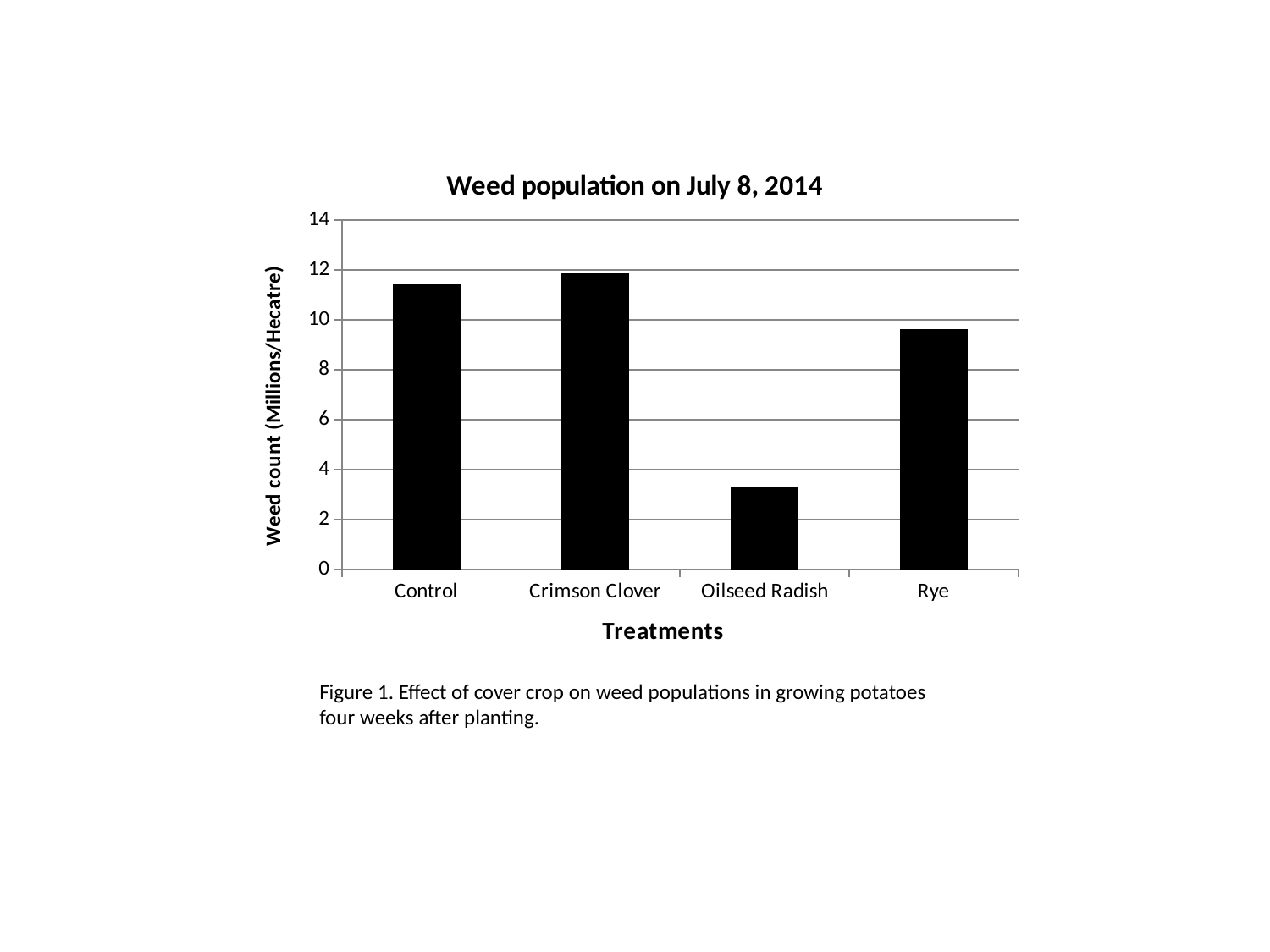
What kind of chart is shown on the slide? bar chart Is the weed count for Control greater or less than 10? greater Is the weed count for Oilseed Radish greater or less than 4? less Which treatment has the lowest weed count? Oilseed Radish Which has a larger weed count, Control or Rye? Control Is the weed count for Rye greater or less than 10? less Which treatment has the highest weed count? Crimson Clover How many treatments are plotted on the x axis? 4 Which has a larger weed count, Rye or Oilseed Radish? Rye What is the title of the chart? Weed population on July 8, 2014 What is the label of the y axis? Weed count (Millions/Hecatre)